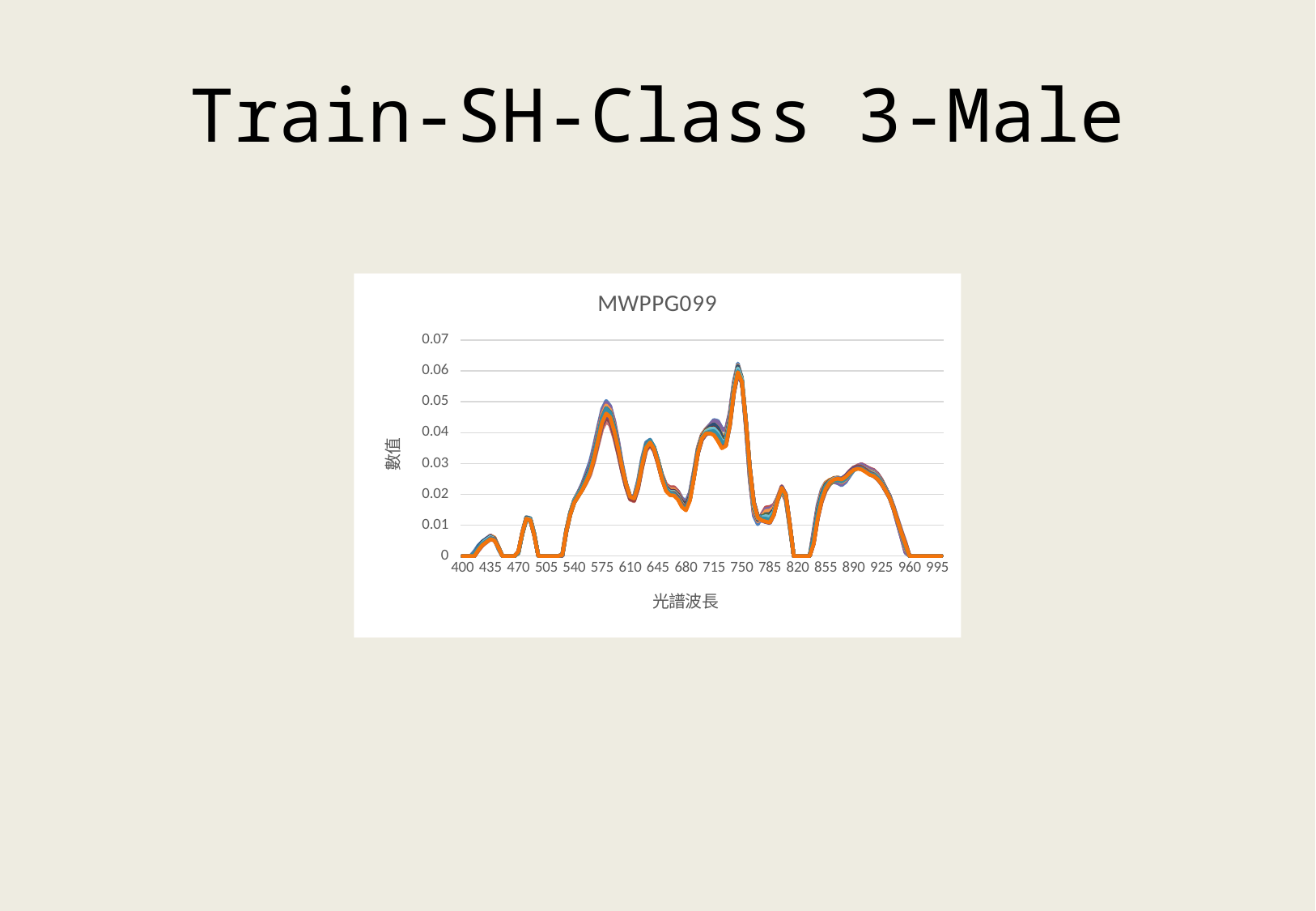
How many wavelength tick labels are shown along the x axis? 18 Do the values rise or fall along the x axis between 925 and 960? fall What is the label on the x axis of the chart? 光譜波長 What kind of chart is shown on the slide? line chart Which has the larger value, the peak near 750 or the peak near 575? the peak near 750 Is the value at wavelength 400 greater or less than 0.01? less Is the value at wavelength 750 greater or less than 0.05? greater Is the value at wavelength 995 greater or less than 0.01? less Do the values rise or fall along the x axis between 820 and 890? rise What is the title of the chart? MWPPG099